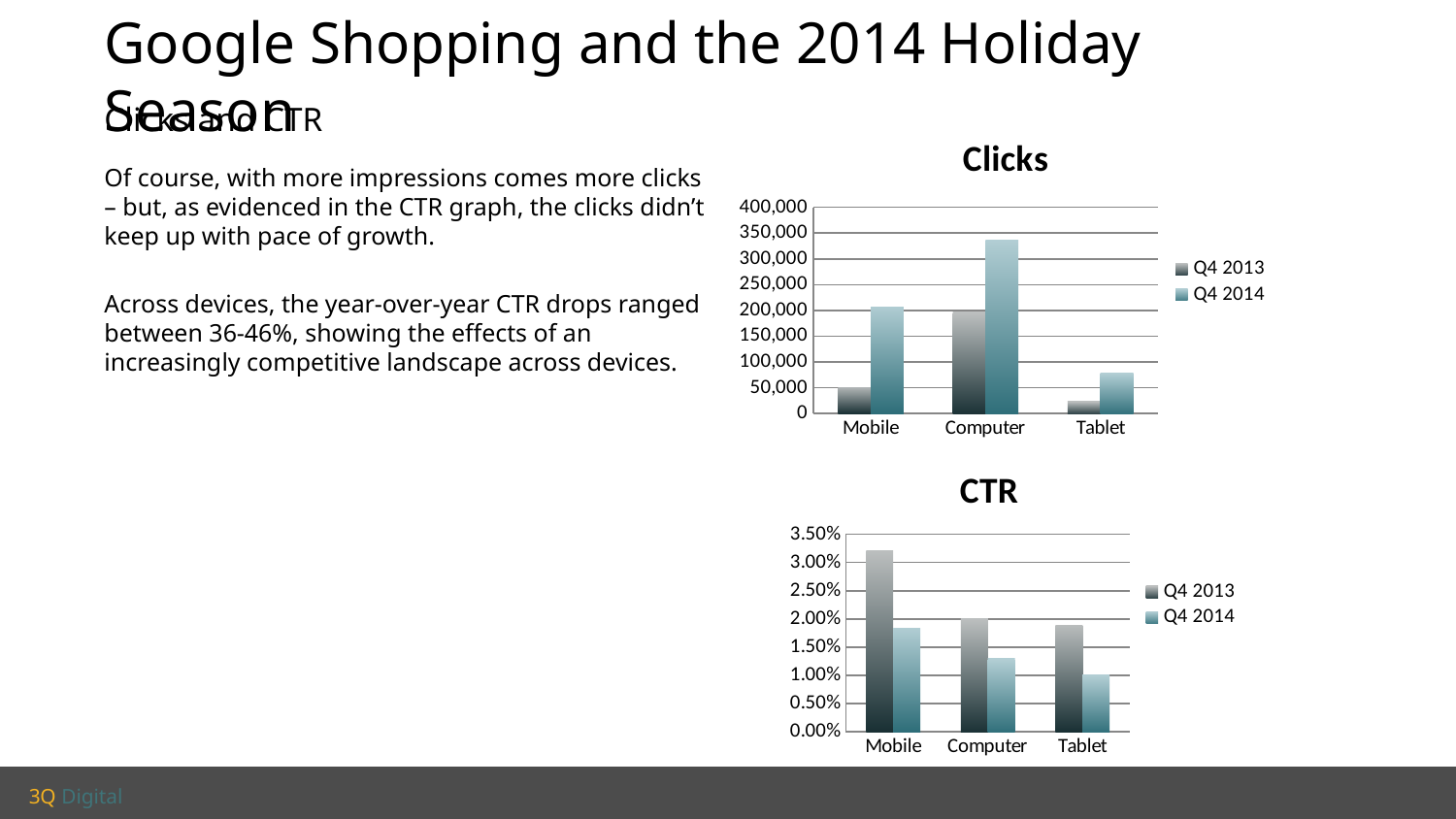
In the CTR chart, is the Q4 2013 value for Mobile greater or less than 3.00%? greater In the Clicks chart, how many series does the legend list? 2 In the Clicks chart, is the Q4 2014 value for Computer greater or less than 300,000? greater In the CTR chart, which device has the highest Q4 2013 CTR? Mobile In the Clicks chart, which device has the lowest Q4 2013 clicks? Tablet In the CTR chart, is the Q4 2014 value for Computer greater or less than 1.50%? less In the Clicks chart, how many device categories are shown on the x axis? 3 In the Clicks chart, which is larger: Q4 2014 clicks for Mobile or Q4 2014 clicks for Computer? Computer In the Clicks chart, what kind of chart is shown? bar chart In the Clicks chart, which device has the highest Q4 2014 clicks? Computer In the CTR chart, what are the two legend entries? Q4 2013 and Q4 2014